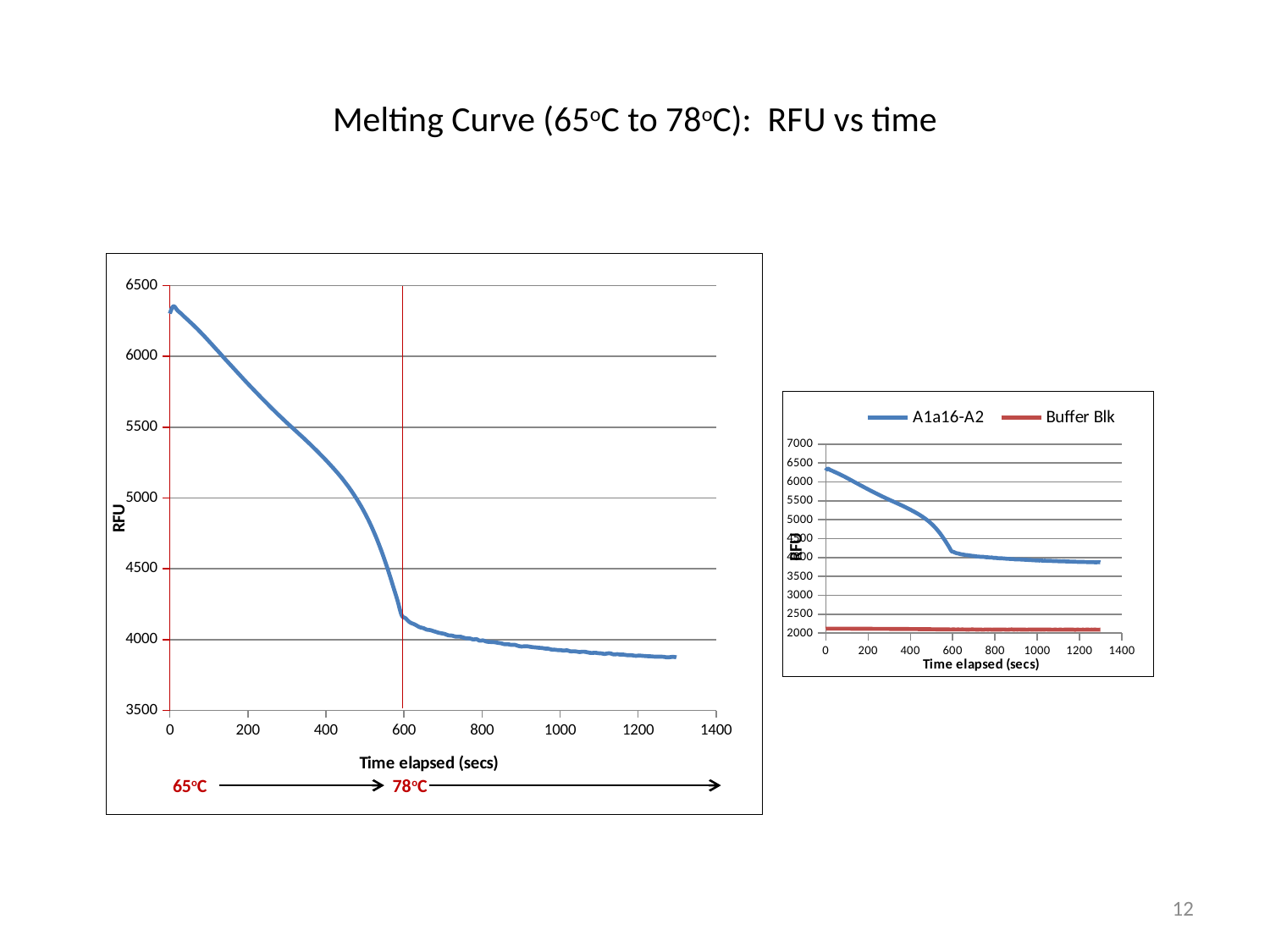
In the large chart on the left, is the RFU value at 0 seconds greater or less than 6000? greater How many series does the legend of the small chart on the right list? 2 What kind of chart is the large chart on the left of the slide? line chart In the large chart on the left, is the RFU value at 200 seconds greater or less than 6000? less In the small chart on the right, is the Buffer Blk value at 600 seconds greater or less than 2500? less What is the y-axis title of the large chart on the left? RFU What is the x-axis title of the large chart on the left? Time elapsed (secs) In the large chart on the left, do the RFU values rise or fall as time elapsed increases? fall In the small chart on the right, which series has the larger value at 1200 seconds, A1a16-A2 or Buffer Blk? A1a16-A2